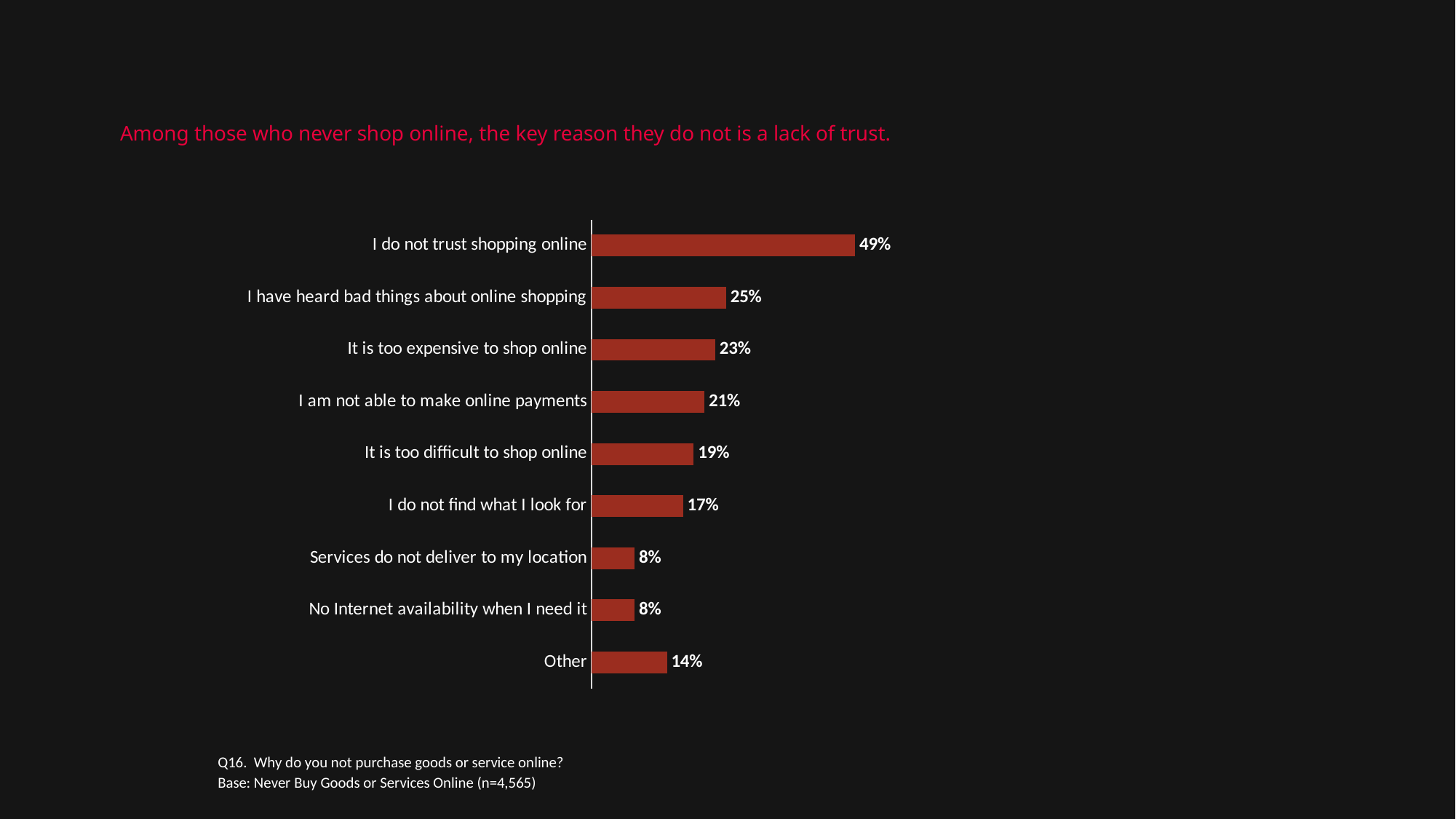
What is the value for "It is too expensive to shop online"? 23% Which reason has the highest percentage? I do not trust shopping online Which is larger: "It is too difficult to shop online" or "Other"? It is too difficult to shop online What is the difference between "I do not trust shopping online" and "I have heard bad things about online shopping"? 24% What is the base sample size (n) stated below the chart? n=4,565 How many reasons (categories) are shown on the chart? 9 What is the difference between "I am not able to make online payments" and "I do not find what I look for"? 4% What percentage is shown for "Other"? 14% What is the lowest value shown on the chart? 8% What percentage of respondents said "I do not trust shopping online"? 49% Which two reasons share the same value of 8%? Services do not deliver to my location; No Internet availability when I need it What kind of chart is shown on the slide? Bar chart